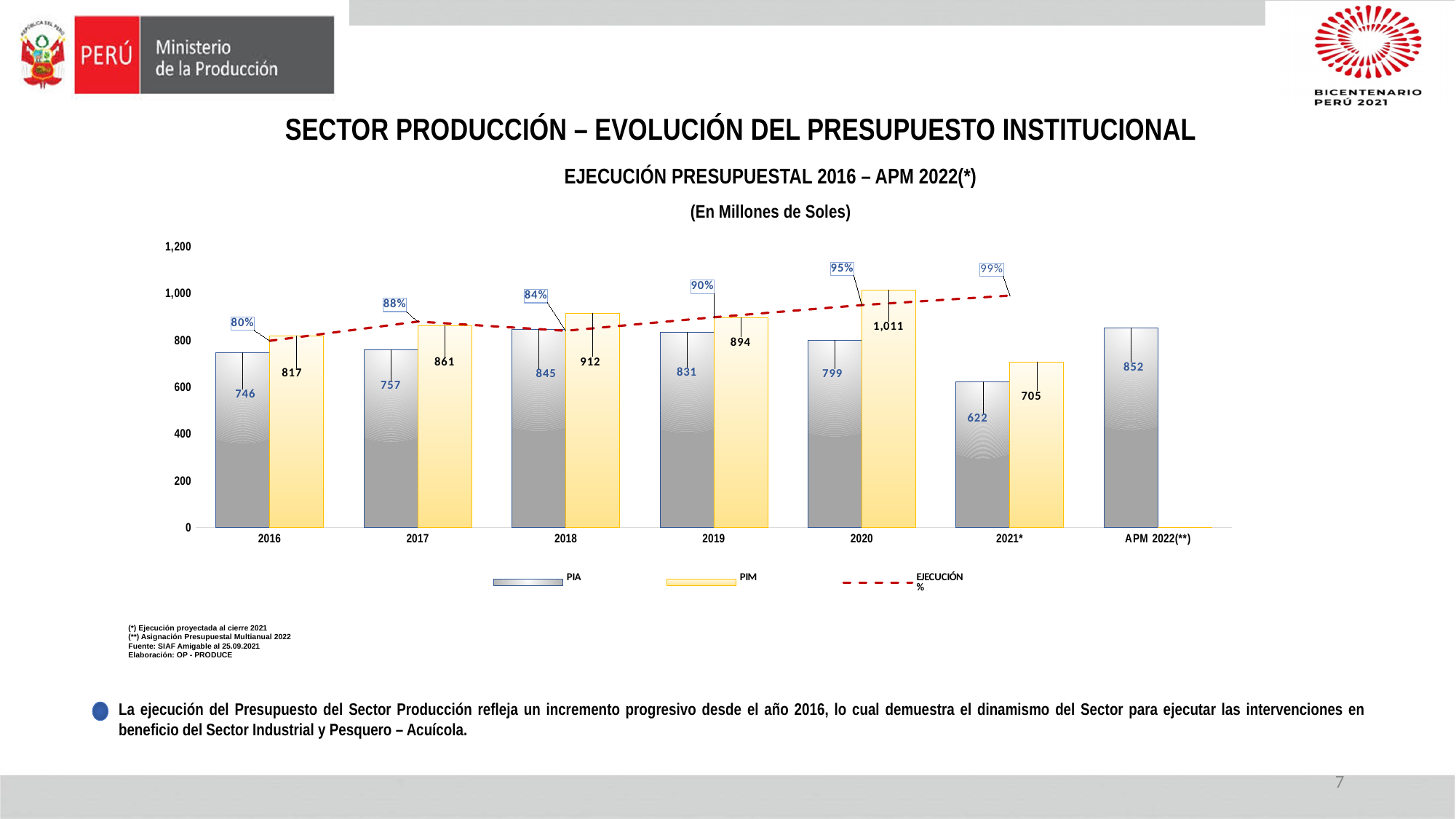
What is the EJECUCIÓN % value for 2019? 90% Which year has the highest PIM value? 2020 How many series does the legend list? 3 Which category has the lowest PIA value? 2021* How many categories are shown on the x axis? 7 What kind of chart is used to show the PIA and PIM values? bar chart What is the PIA value for 2018? 845 What is the difference between the PIM and PIA values for 2017? 104 Is the PIM value for 2021* greater or less than 800? less Which is larger, the PIA value for 2019 or the PIA value for 2020? PIA value for 2019 What is the PIM value for 2020? 1,011 Does the EJECUCIÓN % line generally rise or fall from 2016 to 2021*? rise